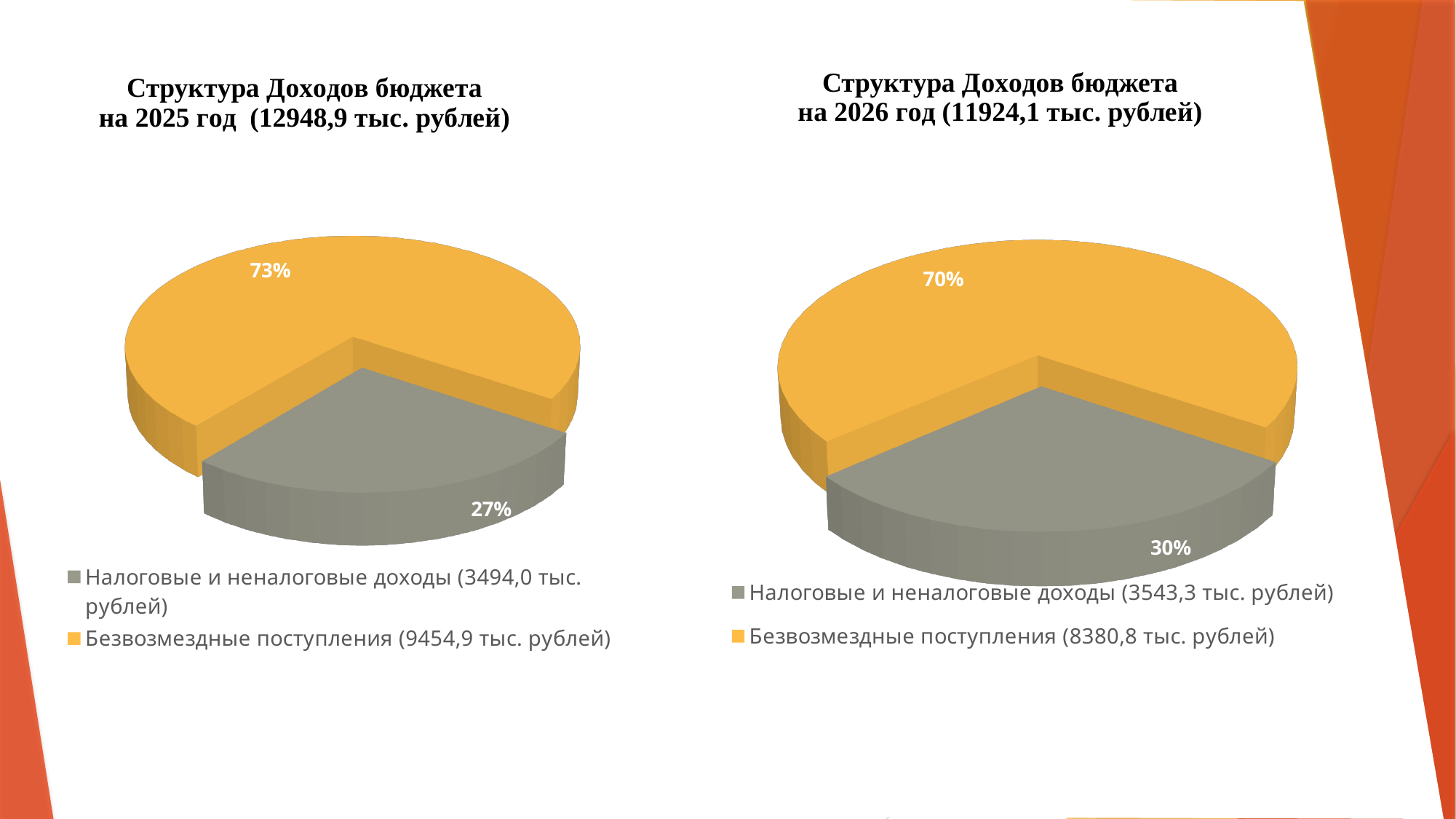
In the 2026 chart (right), what share of budget revenue is Налоговые и неналоговые доходы? 30% In the 2026 chart (right), which category has the smallest slice? Налоговые и неналоговые доходы In the 2025 chart (left), which category has the largest slice? Безвозмездные поступления In the 2026 chart (right), what share of budget revenue is Безвозмездные поступления? 70% In the 2025 chart (left), what share of budget revenue is Безвозмездные поступления? 73% Which chart shows a larger share for Налоговые и неналоговые доходы, the 2025 chart or the 2026 chart? The 2026 chart In the 2025 chart (left), what colour is the slice for Безвозмездные поступления? Orange In the 2025 chart (left), what is the difference in percentage points between Безвозмездные поступления and Налоговые и неналоговые доходы? 46 In the 2026 chart (right), what is the difference in percentage points between Безвозмездные поступления and Налоговые и неналоговые доходы? 40 How many slices does the 2026 chart (right) have? 2 What type of chart is used on the left for the 2025 budget revenue structure? Pie chart